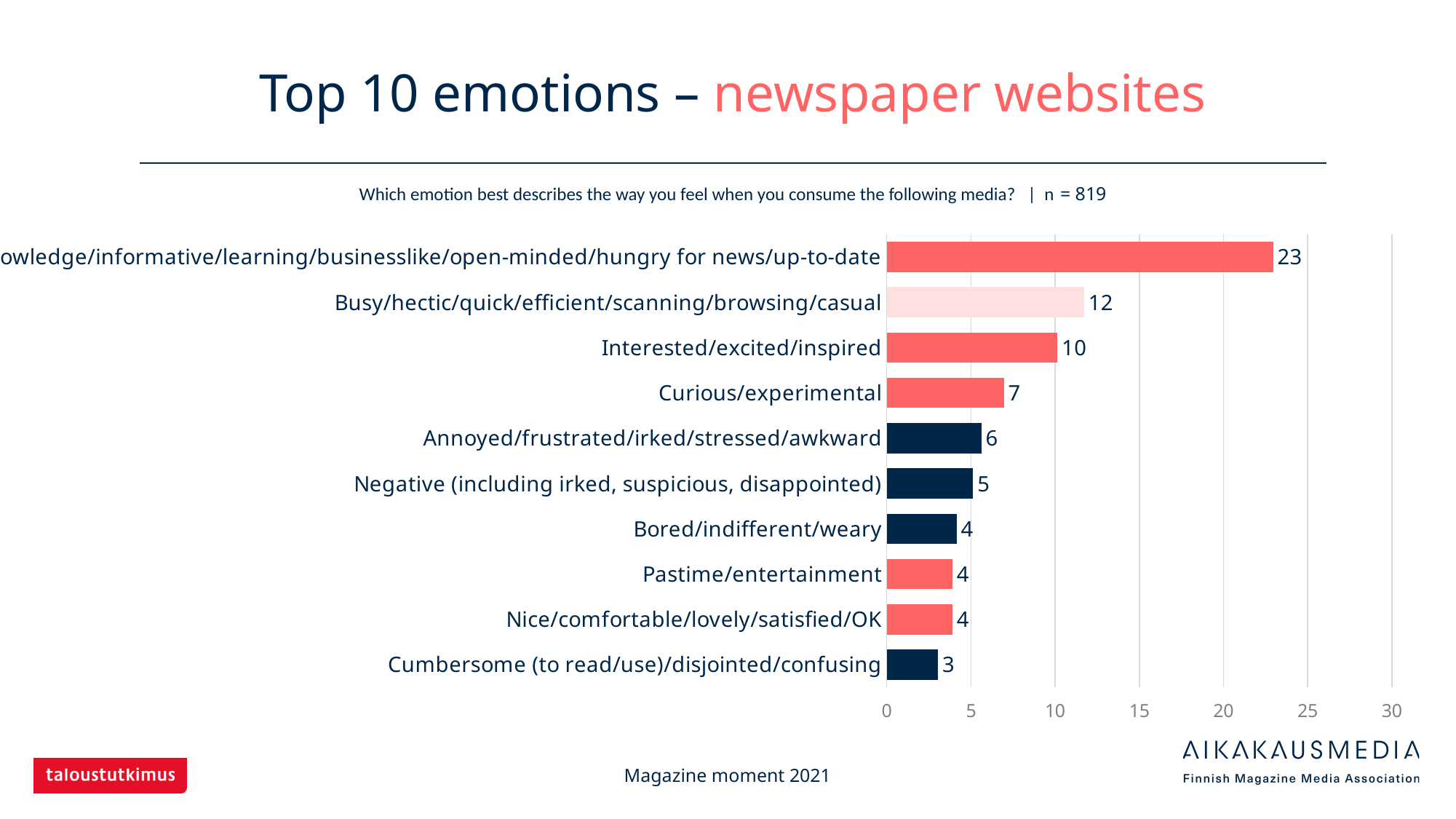
What value is shown for Curious/experimental? 7 How many emotion categories are plotted in the chart? 10 What is the value of the longest bar in the chart? 23 What kind of chart is shown on the slide? bar chart What value is shown for Interested/excited/inspired? 10 Is the value for Curious/experimental greater or less than 10? less What is the difference between the values for Busy/hectic/quick/efficient/scanning/browsing/casual and Interested/excited/inspired? 2 What is the sample size (n) stated on the slide? 819 Which has a larger value: Annoyed/frustrated/irked/stressed/awkward or Bored/indifferent/weary? Annoyed/frustrated/irked/stressed/awkward What value is shown for Busy/hectic/quick/efficient/scanning/browsing/casual? 12 What value is shown for Negative (including irked, suspicious, disappointed)? 5 Which emotion category has the lowest value? Cumbersome (to read/use)/disjointed/confusing